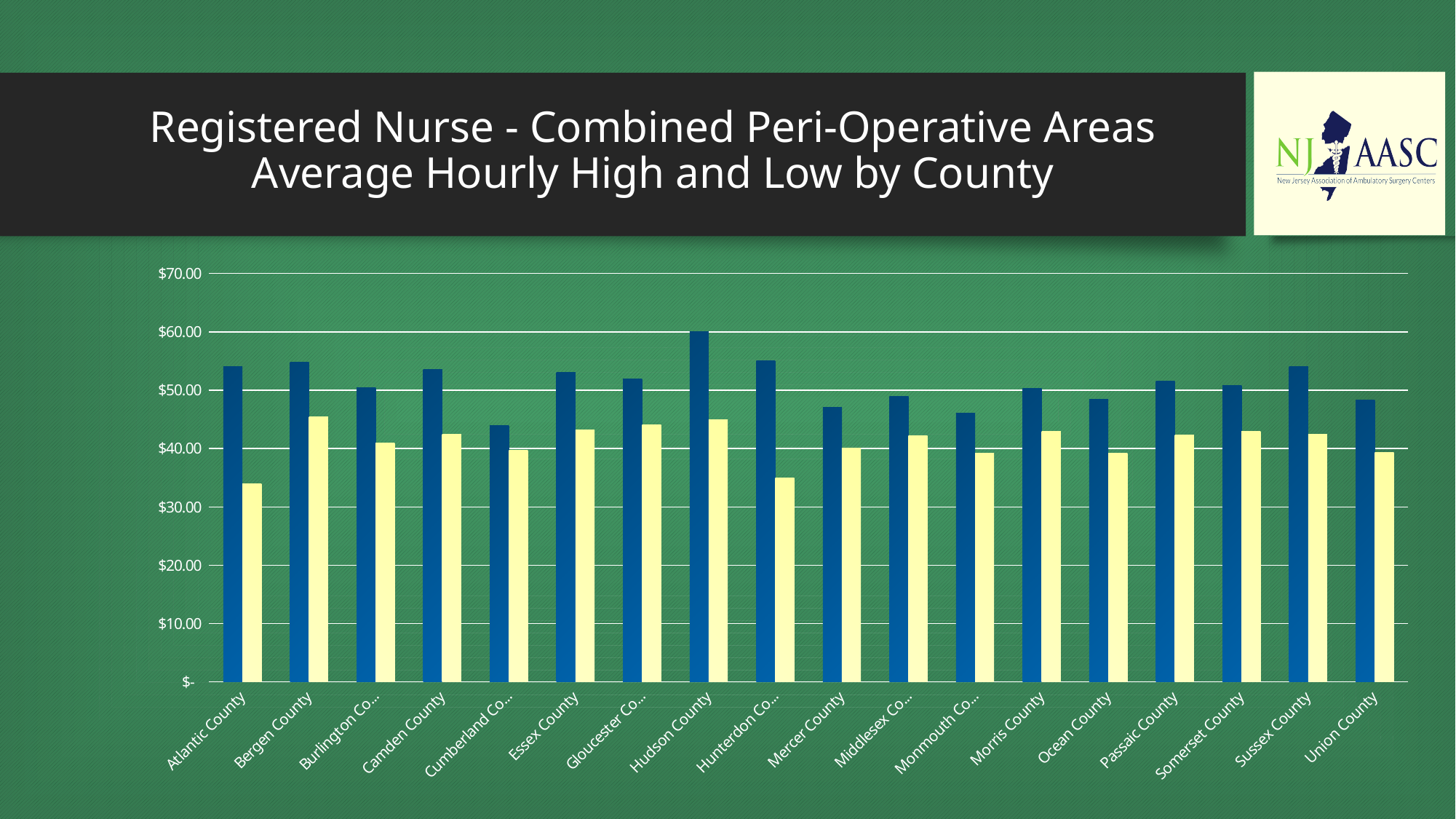
What kind of chart is shown on the slide? bar chart Is the pale yellow bar for Bergen County greater or less than $40.00? greater How many bars are plotted for each county? 2 Is the pale yellow bar for Hunterdon County greater or less than $40.00? less How many counties are shown along the x axis of the chart? 18 Is the pale yellow bar for Atlantic County greater or less than $40.00? less Which has the taller pale yellow bar, Bergen County or Atlantic County? Bergen County Which has the taller dark blue bar, Hudson County or Bergen County? Hudson County Which county has the tallest dark blue bar? Hudson County What is the highest value shown on the y axis of the chart? $70.00